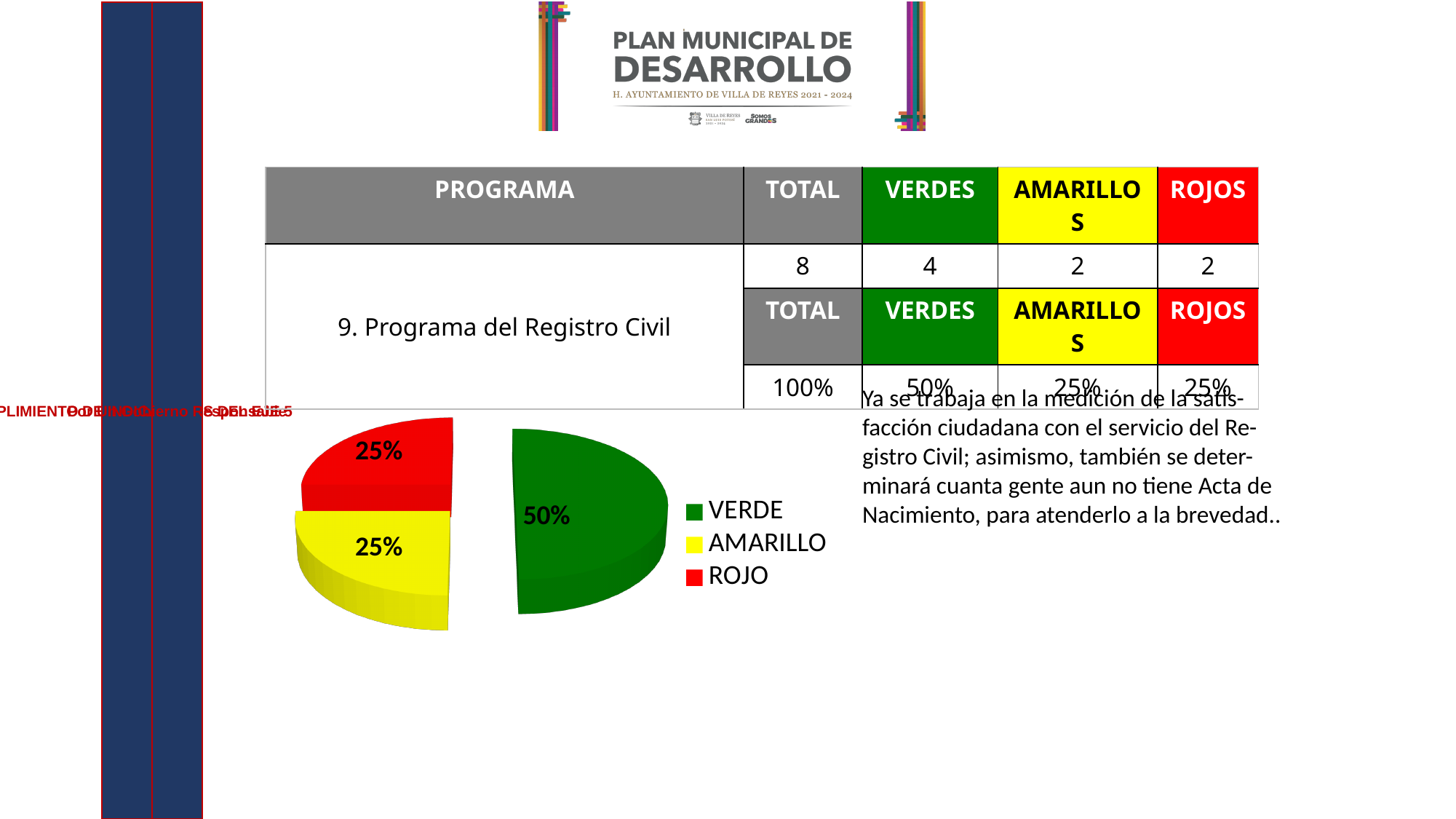
Which is larger in the pie chart, VERDE or ROJO? VERDE Which is larger in the pie chart, VERDE or AMARILLO? VERDE What kind of chart is shown on the slide? Pie chart How many slices does the pie chart have? 3 What colour is the VERDE slice in the pie chart? Green Which slice of the pie chart is the largest? VERDE How many entries does the legend of the pie chart list? 3 What share of the pie chart does AMARILLO represent? 25% What is the difference between the VERDE share and the ROJO share in the pie chart? 25% What share of the pie chart does ROJO represent? 25% What share of the pie chart does VERDE represent? 50% What is the difference between the VERDE share and the AMARILLO share in the pie chart? 25%